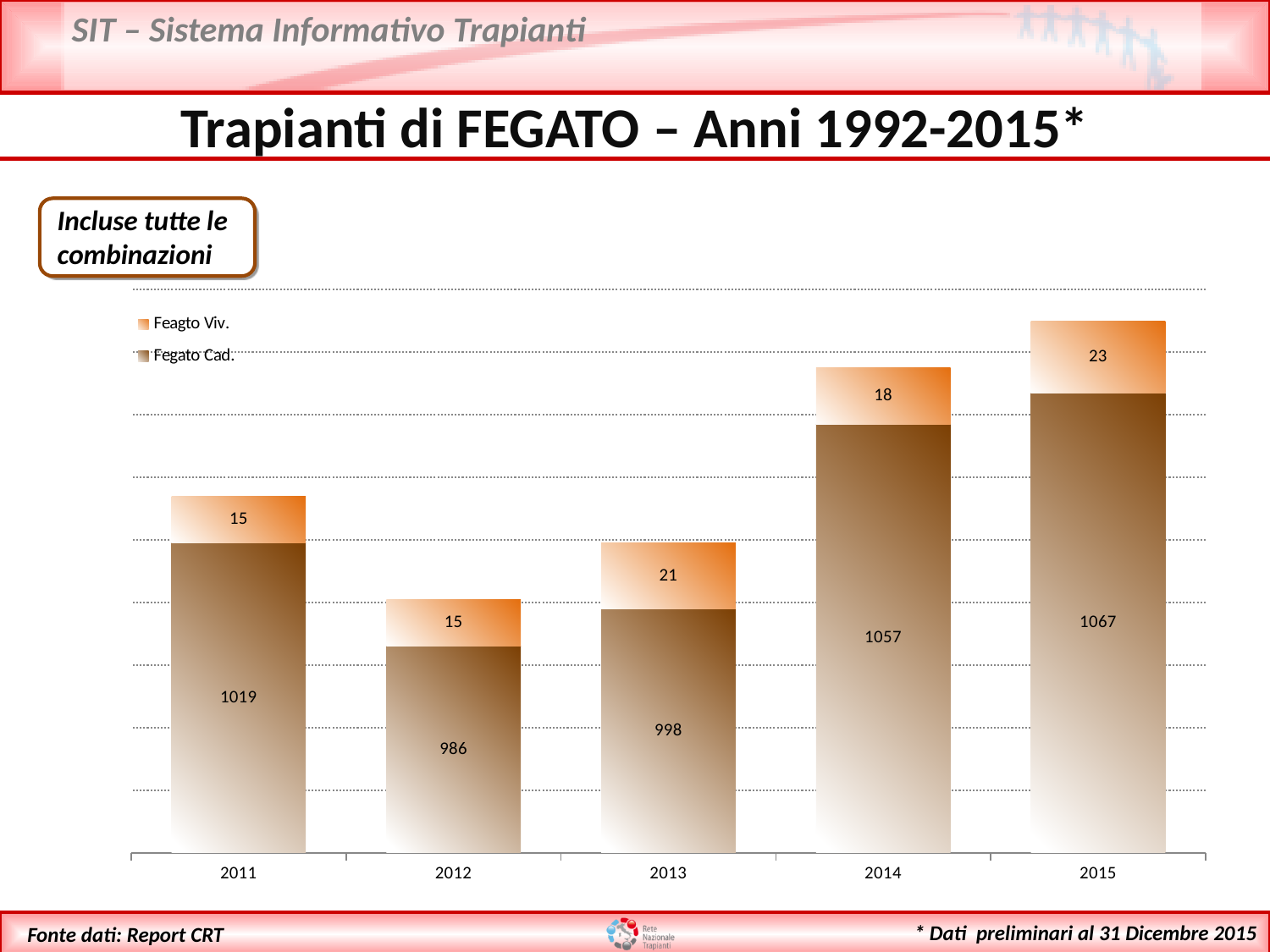
What is the value for Feagto Viv. in 2013? 21 How many years are shown on the x axis? 5 What is the total of the stacked bar for 2015? 1090 Which is larger, the Fegato Cad. value for 2011 or for 2013? 2011 What kind of chart is shown on the slide? Stacked bar chart How many series does the legend list? 2 Which year has the highest value for Feagto Viv.? 2015 What is the value for Fegato Cad. in 2012? 986 What is the difference between the Fegato Cad. values for 2015 and 2014? 10 What is the value for Fegato Cad. in 2014? 1057 Which year has the lowest value for Fegato Cad.? 2012 Which year has the highest value for Fegato Cad.? 2015